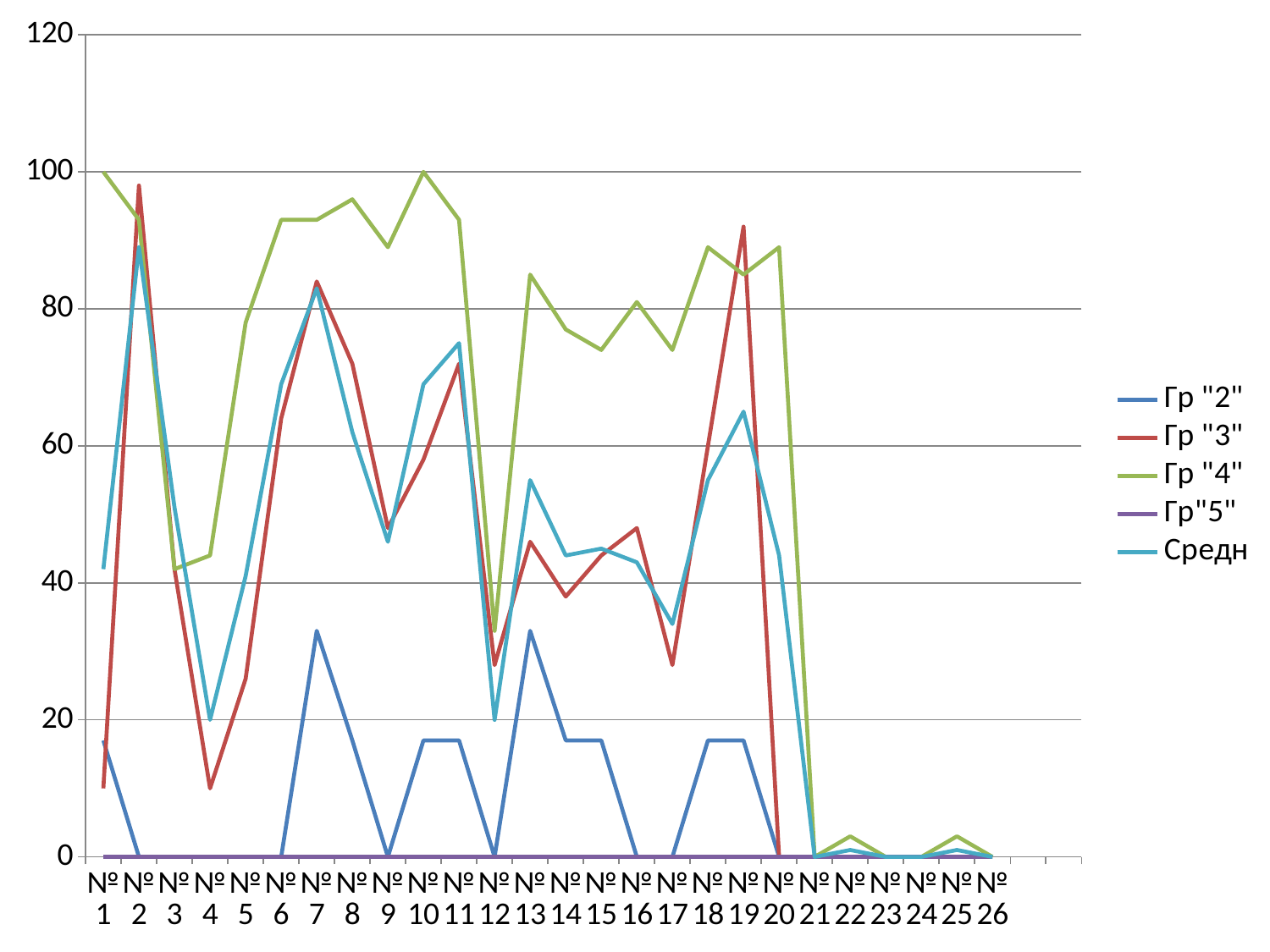
Does the value for Гр "4" rise or fall from № 20 to № 21? fall What type of chart is shown on the slide? line chart At № 5, which is larger: Гр "4" or Гр "3"? Гр "4" Is the value for Гр "3" at № 2 greater or less than 80? greater Which series has the highest value at № 10? Гр "4" Is the value for Гр "4" at № 8 greater or less than 80? greater Is the value for Гр "2" at № 7 greater or less than 40? less Which series is shown in green in the legend? Гр "4" How many series does the legend list? 5 Which series has the lowest value at № 7? Гр"5" How many categories are shown on the x axis? 26